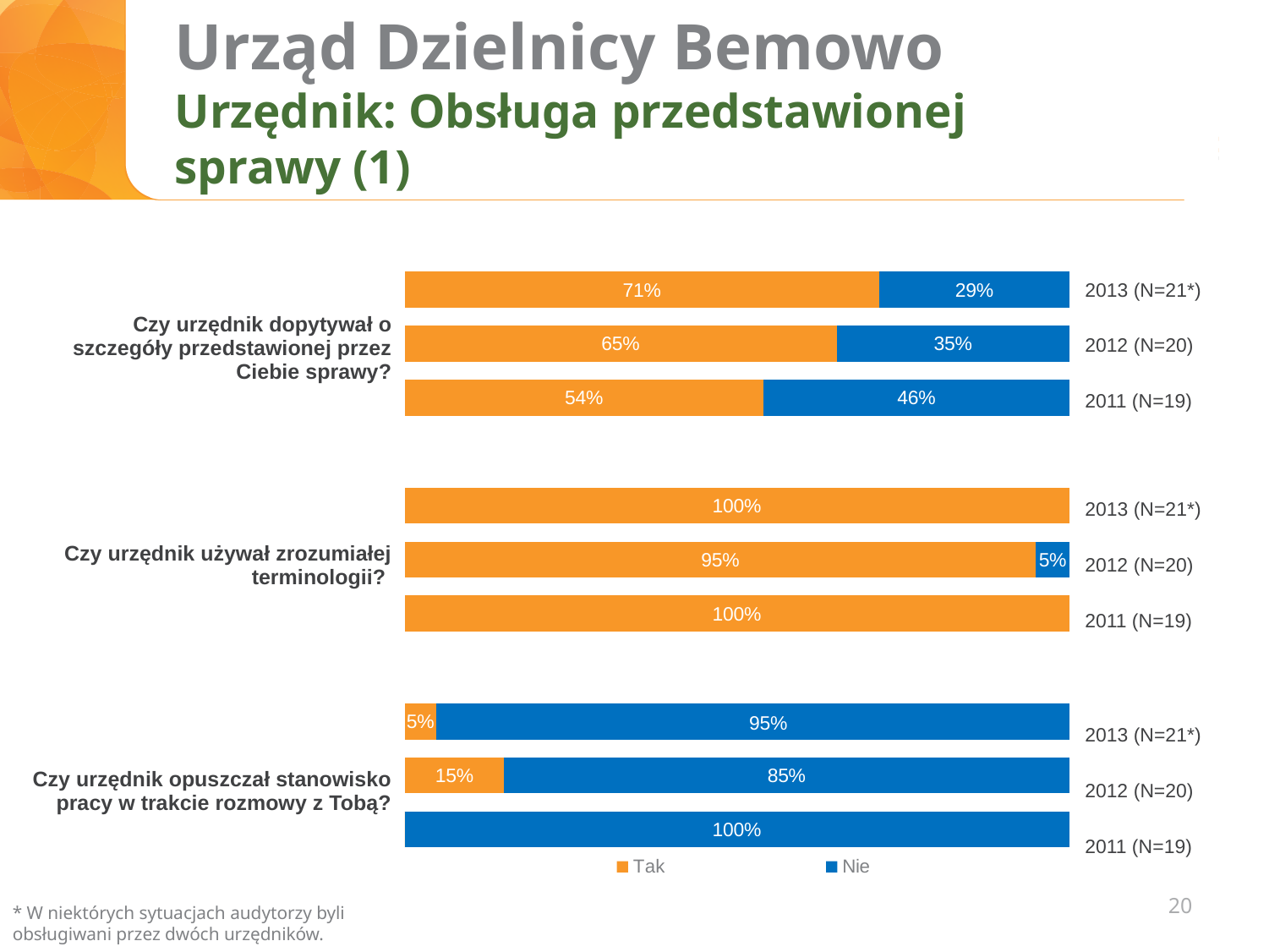
For the question 'Czy urzędnik opuszczał stanowisko pracy w trakcie rozmowy z Tobą?', which year has the lowest 'Nie' value? 2012 (N=20) For the question 'Czy urzędnik dopytywał o szczegóły przedstawionej przez Ciebie sprawy?', does the 'Tak' value rise or fall from 2011 to 2013? rise What is the 'Nie' value for 2012 (N=20) for the question 'Czy urzędnik używał zrozumiałej terminologii?' 5% What kind of chart is shown on the slide? stacked bar chart For the question 'Czy urzędnik dopytywał o szczegóły przedstawionej przez Ciebie sprawy?', which year has the highest 'Tak' value? 2013 (N=21*) What is the 'Tak' value for 2012 (N=20) for the question 'Czy urzędnik opuszczał stanowisko pracy w trakcie rozmowy z Tobą?' 15% For the question 'Czy urzędnik dopytywał o szczegóły przedstawionej przez Ciebie sprawy?', what is the difference between the 'Tak' values for 2013 (N=21*) and 2011 (N=19)? 17% What are the two series named in the legend? Tak and Nie How many bars are plotted on the chart in total? 9 What is the 'Tak' value for 2013 (N=21*) for the question 'Czy urzędnik dopytywał o szczegóły przedstawionej przez Ciebie sprawy?' 71% What is the 'Nie' value for 2011 (N=19) for the question 'Czy urzędnik dopytywał o szczegóły przedstawionej przez Ciebie sprawy?' 46% How many series does the legend list? 2